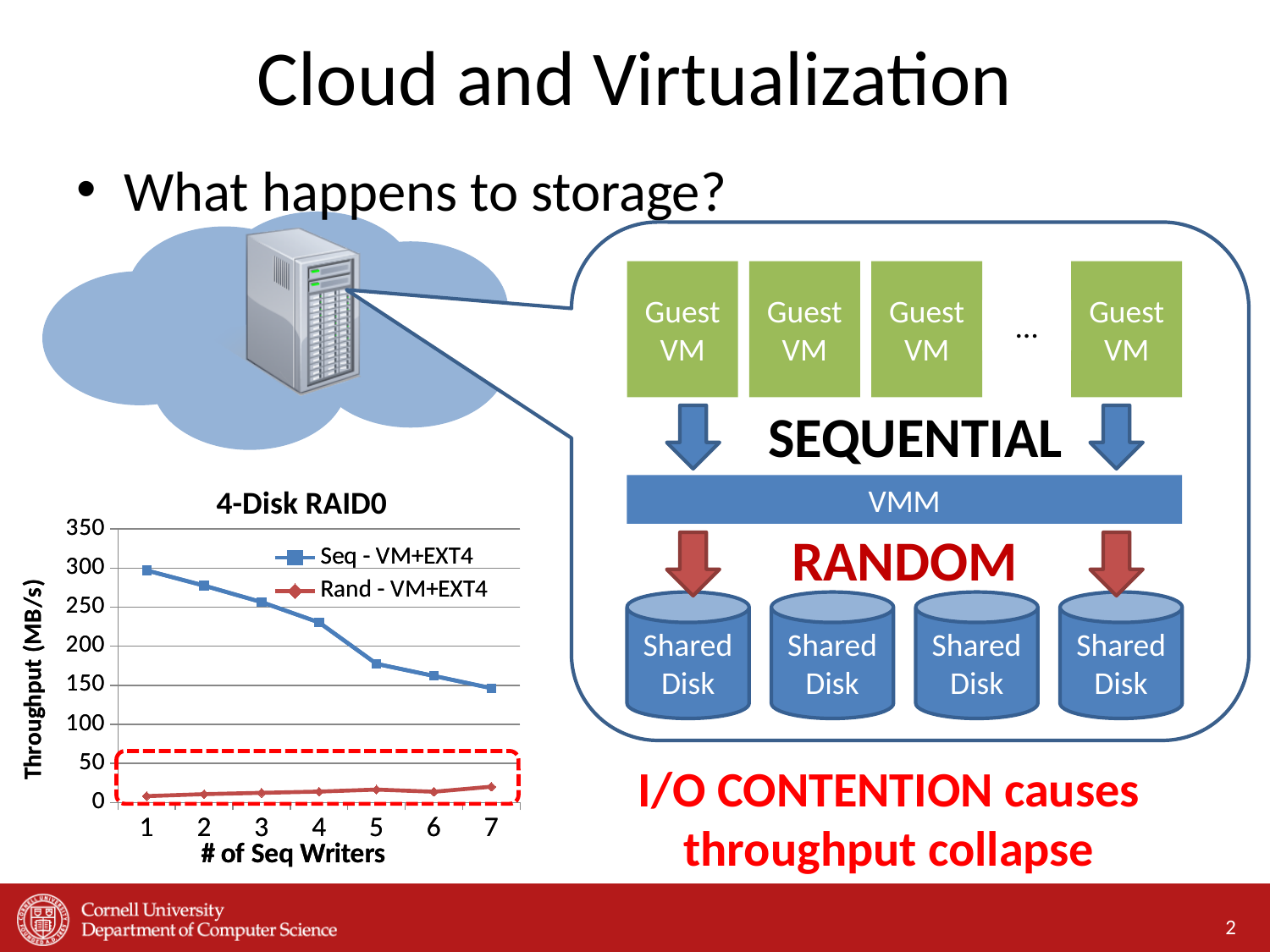
What is the label of the y axis in the "4-Disk RAID0" chart? Throughput (MB/s) What are the two series named in the legend of the "4-Disk RAID0" chart? Seq - VM+EXT4 and Rand - VM+EXT4 In the "4-Disk RAID0" chart, is the Seq - VM+EXT4 throughput at 1 writer greater or less than 250? greater In the "4-Disk RAID0" chart, does the Seq - VM+EXT4 throughput rise or fall as the number of sequential writers increases? fall In the "4-Disk RAID0" chart, which series has the larger throughput at 4 writers, Seq - VM+EXT4 or Rand - VM+EXT4? Seq - VM+EXT4 In the "4-Disk RAID0" chart, is the Seq - VM+EXT4 throughput at 7 writers greater or less than 200? less In the "4-Disk RAID0" chart, at which number of sequential writers is the Seq - VM+EXT4 throughput lowest? 7 In the "4-Disk RAID0" chart, is the Rand - VM+EXT4 throughput at 7 writers greater or less than 50? less How many series does the legend of the "4-Disk RAID0" chart list? 2 What type of chart is the "4-Disk RAID0" chart? line chart How many points along the x axis (# of Seq Writers) are plotted in the "4-Disk RAID0" chart? 7 In the "4-Disk RAID0" chart, at which number of sequential writers is the Seq - VM+EXT4 throughput highest? 1